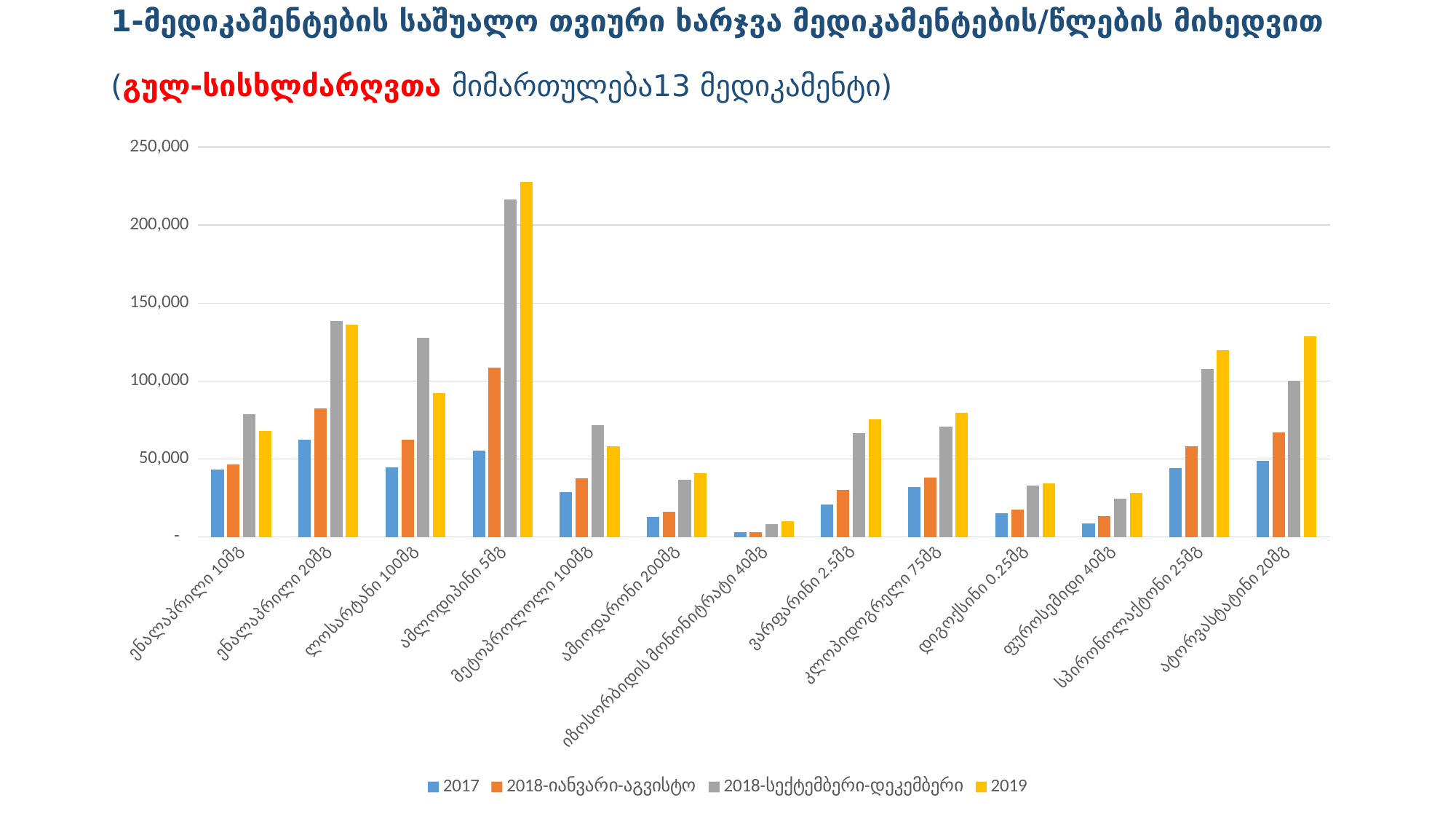
What kind of chart is shown on the slide? bar chart Is the 2019 value for ატორვასტატინი 20მგ greater or less than 100,000? greater Is the 2017 value for ენალაპრილი 20მგ greater or less than 50,000? greater For ლოსარტანი 100მგ, which is larger: the 2018-სექტემბერი-დეკემბერი value or the 2019 value? 2018-სექტემბერი-დეკემბერი Which medication has the lowest 2019 value? იზოსორბიდის მონონიტრატი 40მგ Is the 2019 value for ამლოდიპინი 5მგ greater or less than 200,000? greater Which colour represents the 2019 series in the legend? yellow Which medication has the highest 2019 value? ამლოდიპინი 5მგ How many medication categories are shown on the x axis? 13 For ატორვასტატინი 20მგ, which is larger: the 2017 value or the 2019 value? 2019 How many series does the legend list? 4